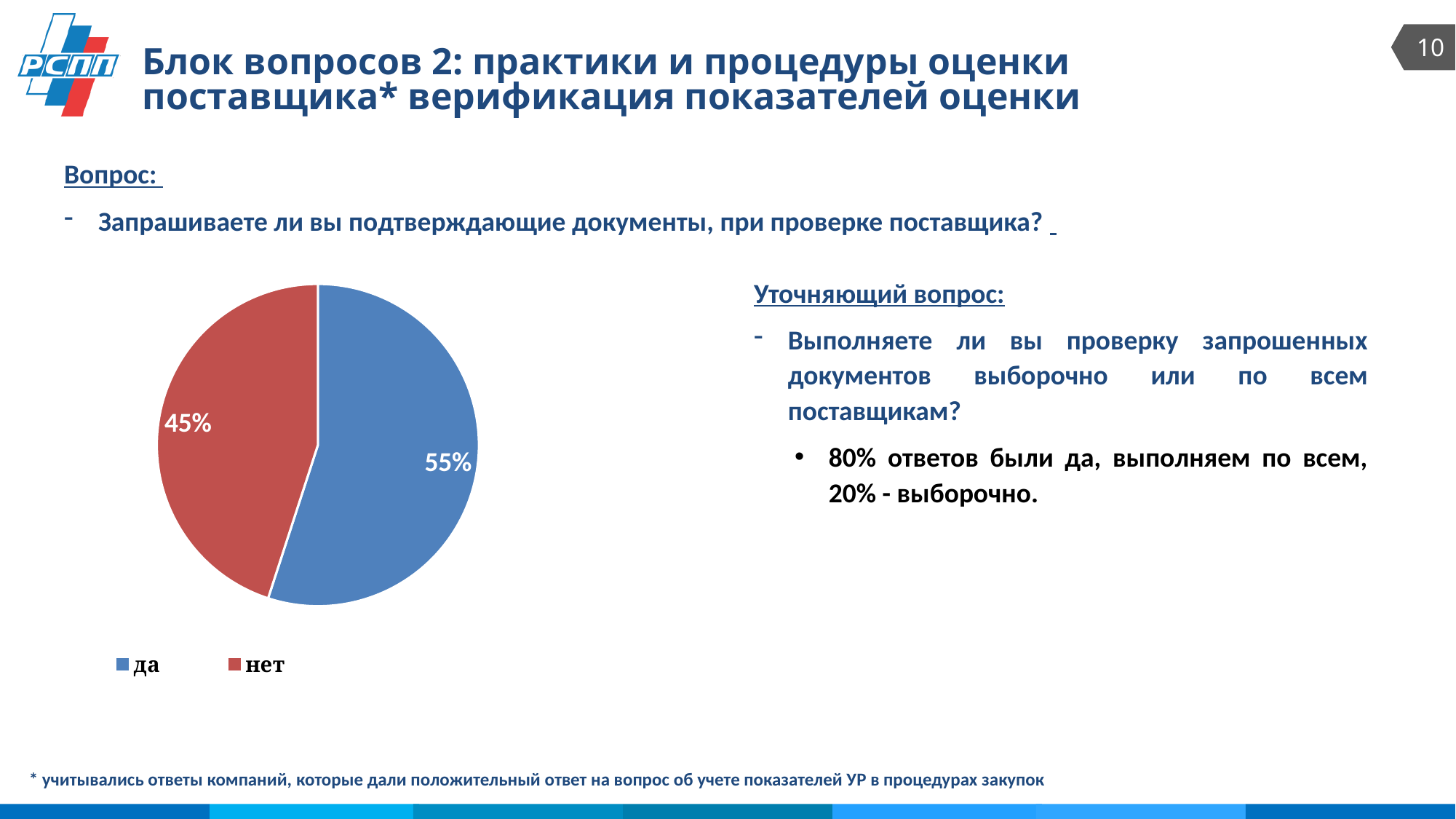
Is the share for "нет" greater or less than 50%? less Which slice of the pie chart is the smallest? нет What share of the pie chart is labelled "да"? 55% What colour is the "да" slice in the pie chart? blue How many slices does the pie chart have? 2 What share of the pie chart is labelled "нет"? 45% What colour is the "нет" slice in the pie chart? red What is the difference in percentage points between the "да" and "нет" slices? 10 What kind of chart is shown on the slide? pie chart Which slice of the pie chart is the largest? да How many entries does the chart legend list? 2 Which slice is larger, "да" or "нет"? да